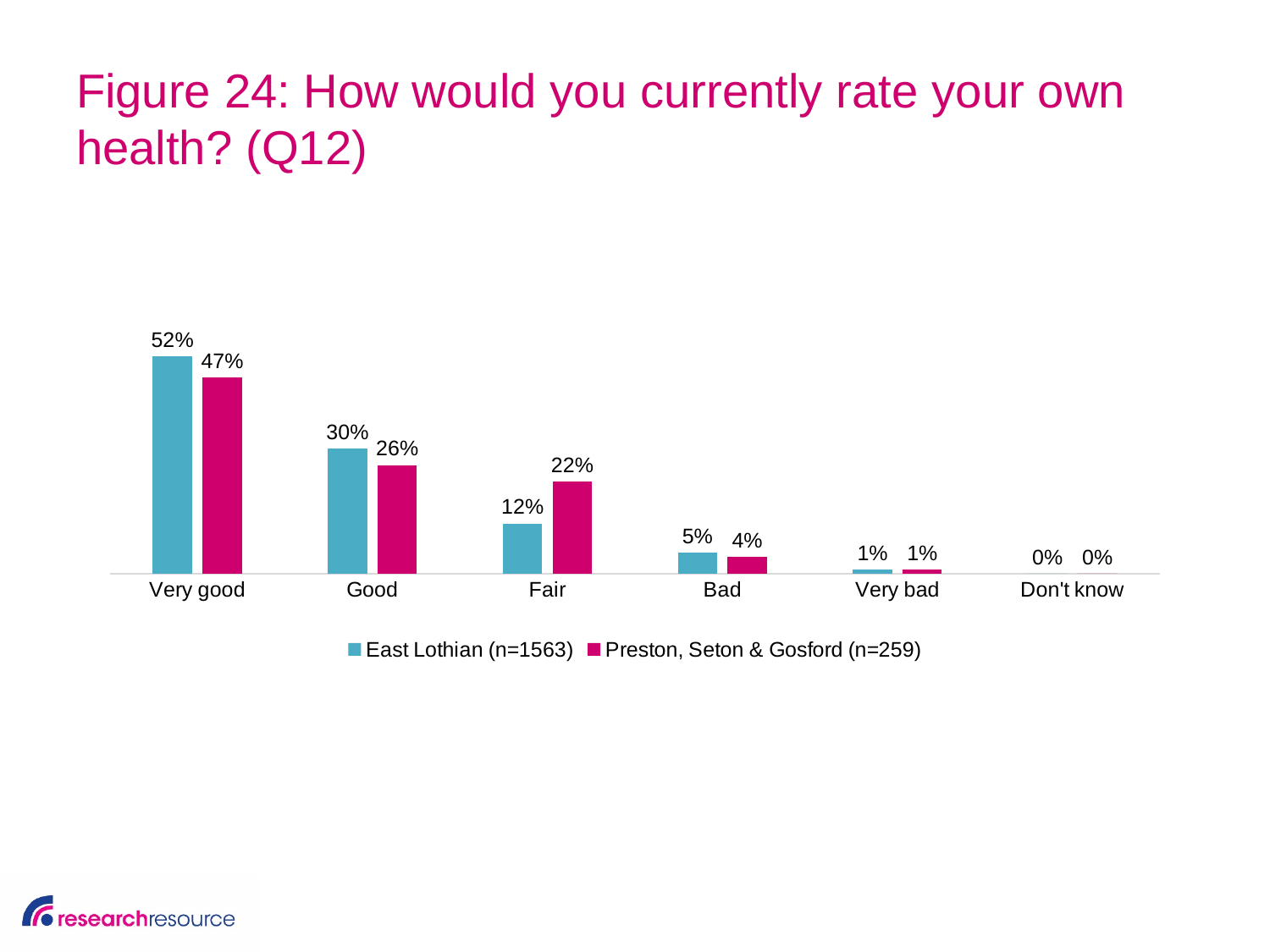
How many categories are shown on the x axis? 6 What kind of chart is shown on the slide? Bar chart Which category has the lowest value for Preston, Seton & Gosford? Don't know What percentage of East Lothian respondents rated their health as Very good? 52% What is the difference between the East Lothian and Preston, Seton & Gosford values for Very good? 5% How many series does the legend list? 2 What is the value for Preston, Seton & Gosford in the Good category? 26% What is the sample size (n) for the East Lothian series in the legend? 1563 Which category has the highest value for East Lothian? Very good What percentage of Preston, Seton & Gosford respondents rated their health as Fair? 22% Which series has the larger value for Fair, East Lothian or Preston, Seton & Gosford? Preston, Seton & Gosford What is the difference between the Preston, Seton & Gosford and East Lothian values for Fair? 10%